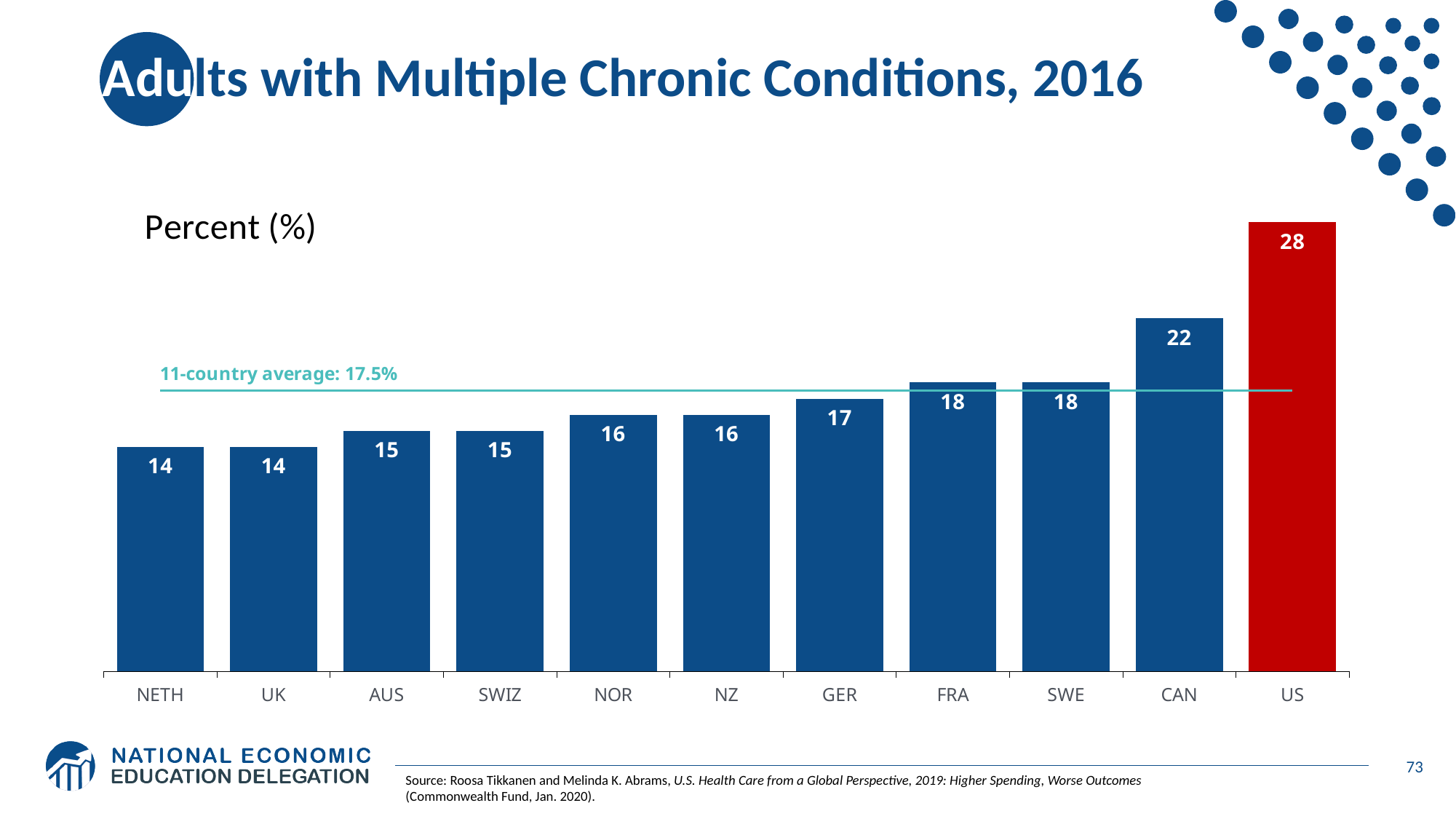
Which country has the highest value? US Do the values generally rise or fall from NETH to US along the x axis? Rise What is the value for CAN? 22 Which has a larger value, AUS or CAN? CAN What is the 11-country average shown on the chart? 17.5% What is the difference between the values for the US and CAN? 6 Which has a larger value, NOR or FRA? FRA How many countries are shown on the chart? 11 What kind of chart is shown on the slide? Bar chart What is the value for the US? 28 What is the value for GER? 17 What is the difference between the values for SWE and NETH? 4